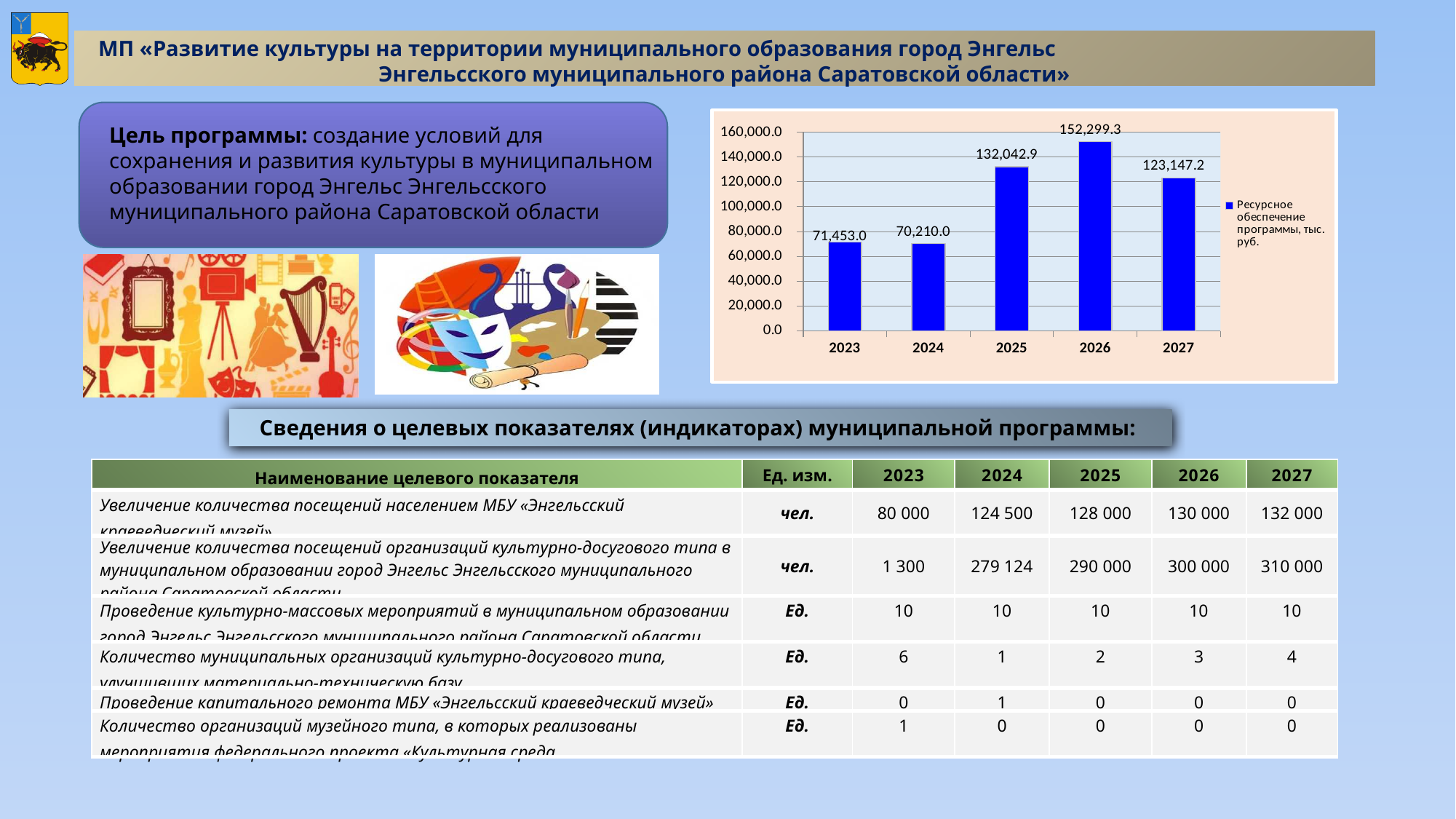
What is the value for 2026 in the bar chart? 152,299.3 Which is larger in the bar chart, the value for 2025 or the value for 2027? 2025 How many series does the legend of the bar chart list? 1 What is the value for 2027 in the bar chart? 123,147.2 Which year has the highest value in the bar chart? 2026 Is the value for 2025 in the bar chart greater or less than 120,000.0? greater How many years are shown on the x axis of the bar chart? 5 What type of chart is shown on the slide? bar chart What is the difference between the values for 2026 and 2025 in the bar chart? 20,256.4 Which year has the lowest value in the bar chart? 2024 What is the difference between the values for 2023 and 2024 in the bar chart? 1,243.0 What is the value for 2024 in the bar chart? 70,210.0